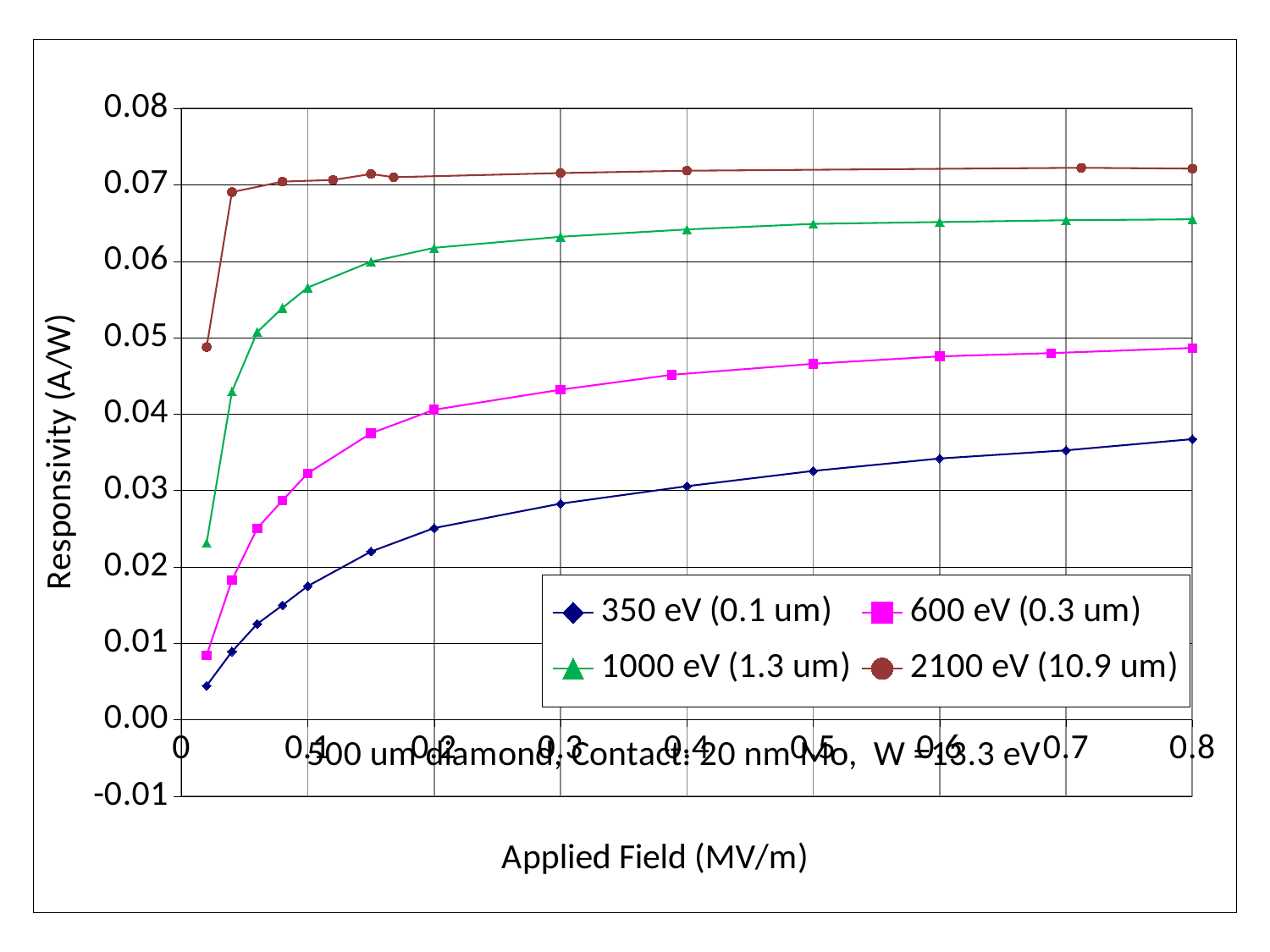
Is the responsivity of the 1000 eV (1.3 um) series at 0.2 MV/m greater or less than 0.06? greater What kind of chart is shown on the slide? line chart Is the responsivity of the 2100 eV (10.9 um) series at 0.8 MV/m greater or less than 0.07? greater Is the responsivity of the 350 eV (0.1 um) series at 0.8 MV/m greater or less than 0.04? less How many series does the legend list? 4 Which series has the highest responsivity across the applied field range? 2100 eV (10.9 um) What is the label of the y axis? Responsivity (A/W) Which series has the lowest responsivity across the applied field range? 350 eV (0.1 um) What is the label of the x axis? Applied Field (MV/m) Does the responsivity of the 350 eV (0.1 um) series rise or fall as the applied field increases? rise At 0.4 MV/m, which series has the higher responsivity: 1000 eV (1.3 um) or 600 eV (0.3 um)? 1000 eV (1.3 um)